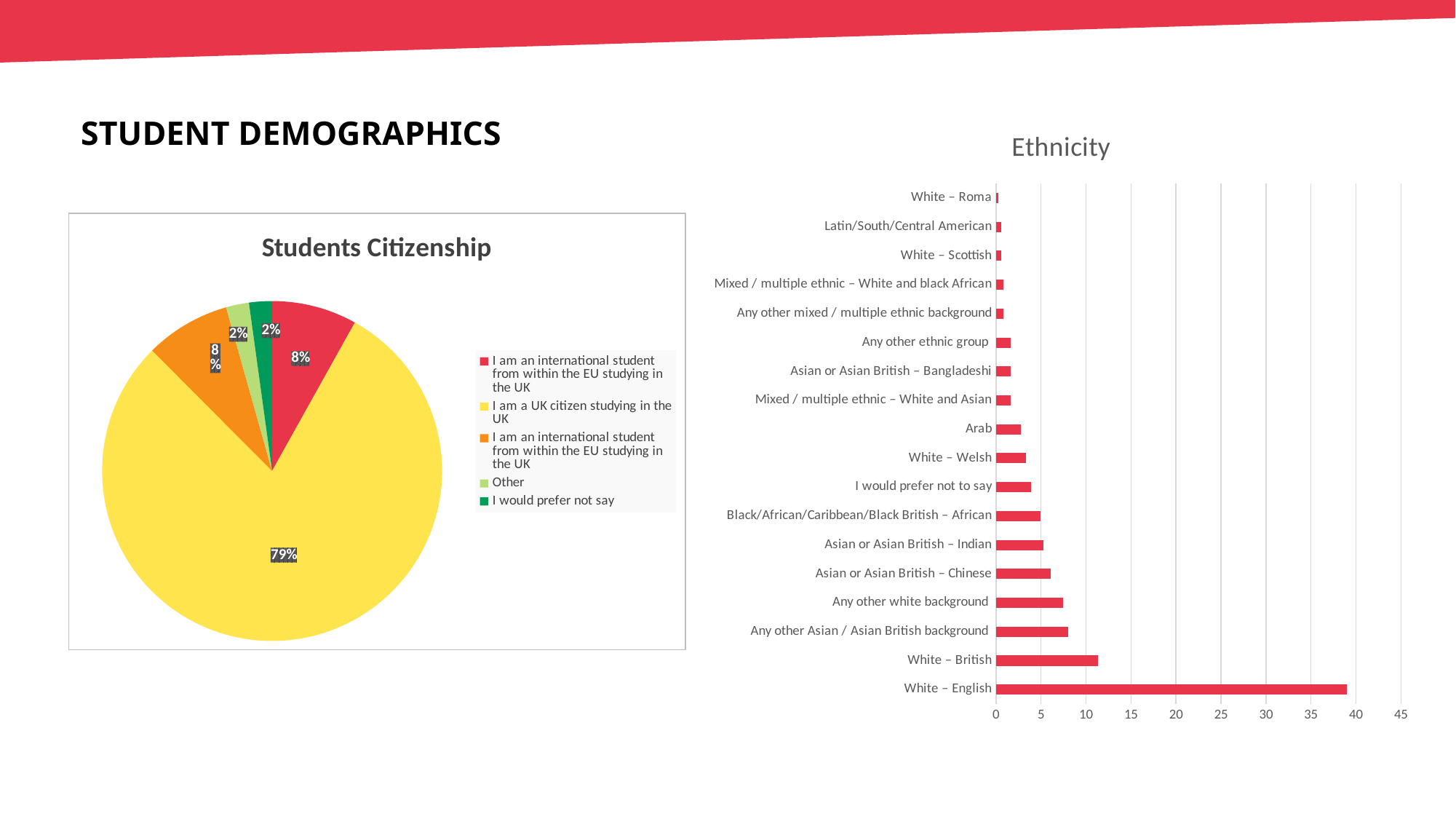
What type of chart is the Ethnicity chart? Bar chart In the Students Citizenship pie chart, which category has the largest share? I am a UK citizen studying in the UK In the Students Citizenship pie chart, what share is 'I would prefer not say'? 2% In the Students Citizenship pie chart, what share is labelled 'Other'? 2% In the Ethnicity chart, is the value for White – English greater or less than 35? greater How many entries does the legend of the Students Citizenship pie chart list? 5 In the Students Citizenship pie chart, what percentage of students are UK citizens studying in the UK? 79% In the Ethnicity chart, is the value for Arab greater or less than 5? less In the Ethnicity chart, which category has the highest value? White – English In the Ethnicity chart, which category has the lowest value? White – Roma In the Ethnicity chart, which is larger: White – British or Any other white background? White – British What type of chart is the Students Citizenship chart? Pie chart